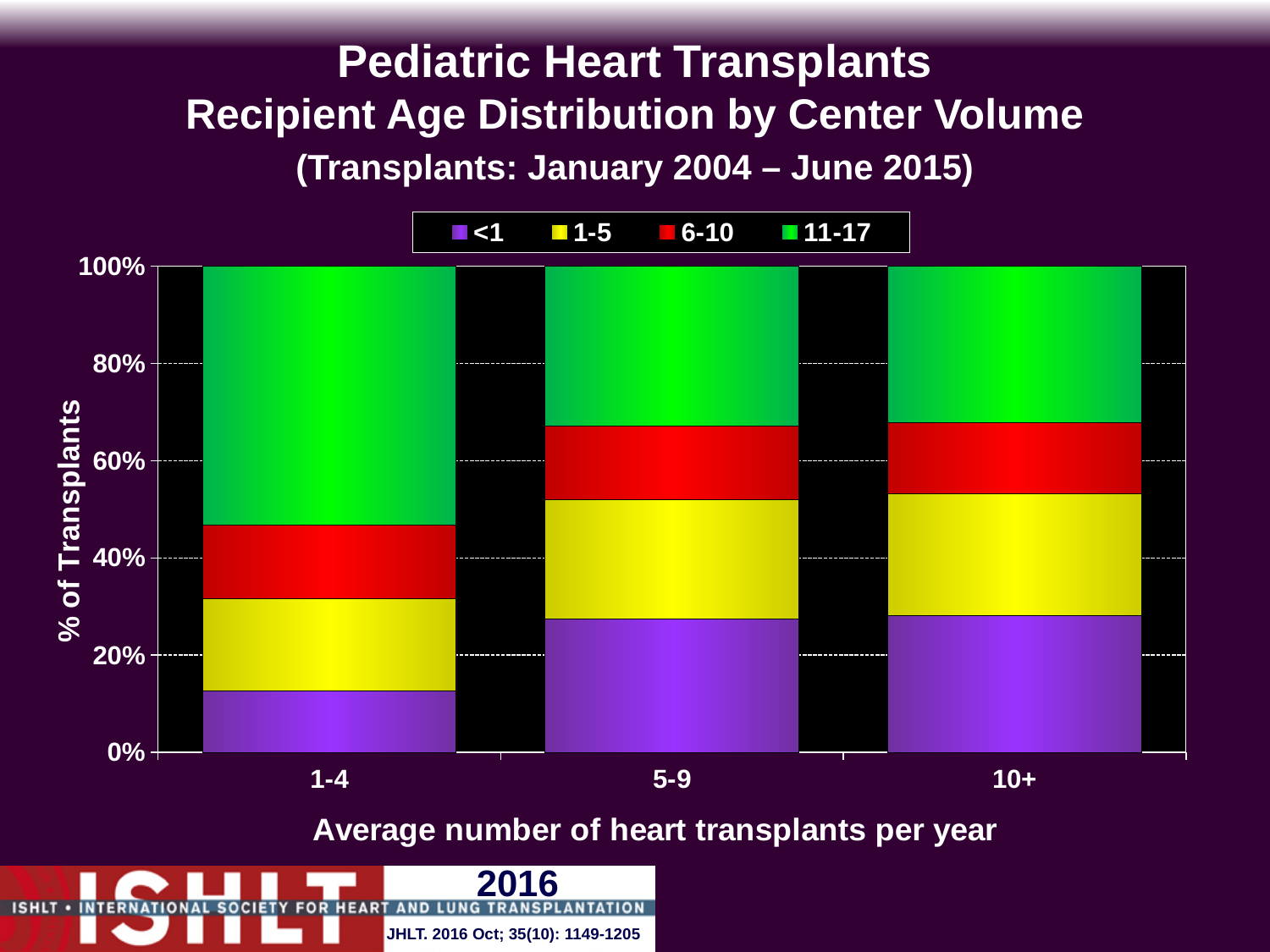
How many center volume categories are shown on the x axis? 3 What is the label of the x axis? Average number of heart transplants per year How many recipient age groups does the legend list? 4 Is the share of recipients aged <1 in the 5-9 transplants per year category greater or less than 20%? greater Which center volume category has the smallest share of recipients aged <1? 1-4 Is the share of recipients aged 11-17 larger in the 1-4 category or the 10+ category? 1-4 What kind of chart is shown on the slide? Stacked bar chart Is the share of recipients aged 11-17 in the 1-4 transplants per year category greater or less than 40%? greater Does the share of recipients aged 11-17 rise or fall from the 1-4 category to the 10+ category? fall Is the share of recipients aged 11-17 in the 5-9 transplants per year category greater or less than 40%? less Which center volume category has the largest share of recipients aged 11-17? 1-4